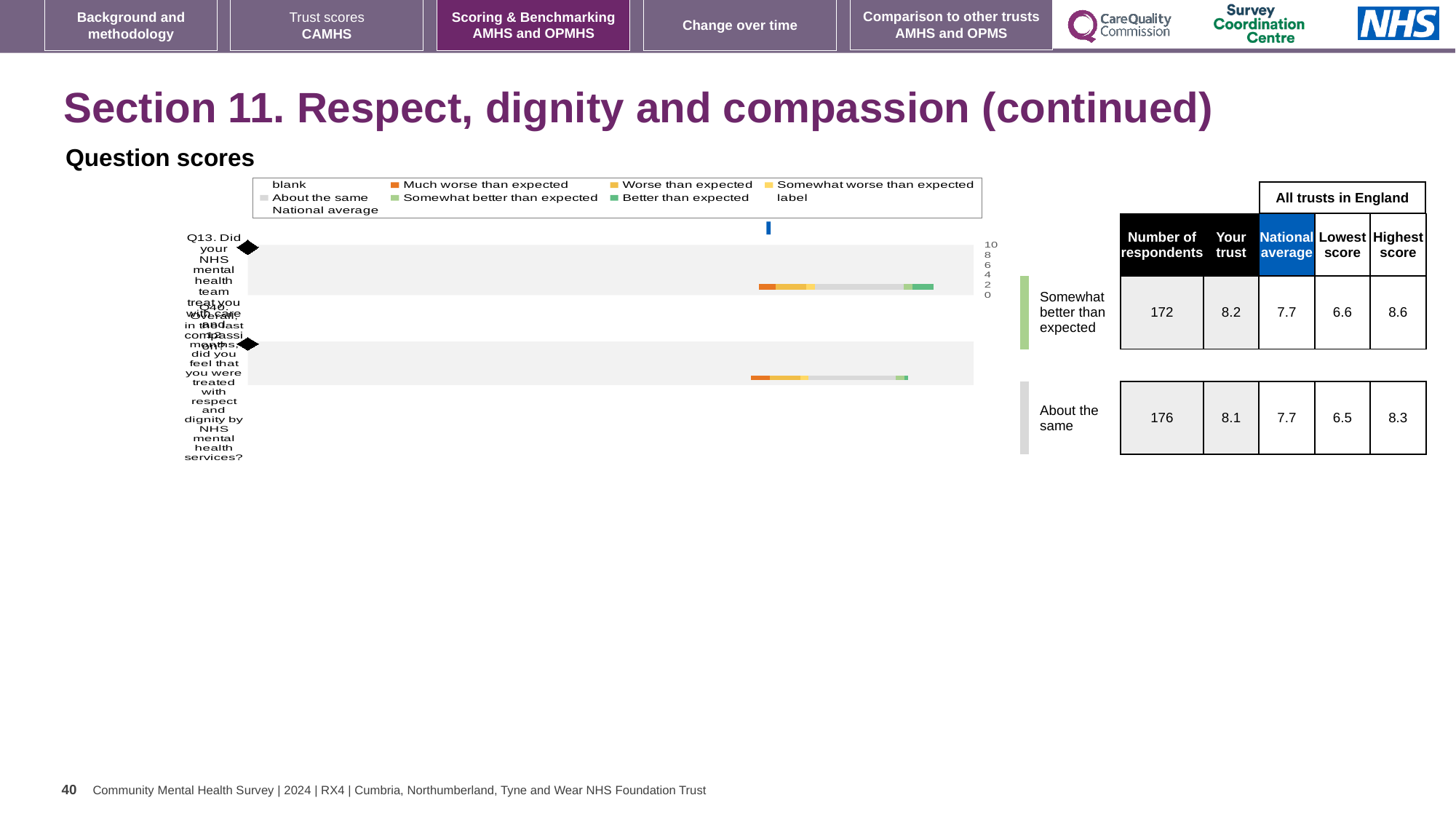
What kind of chart is shown under 'Question scores'? bar chart In the table beside the chart, what is the 'Lowest score' for the row labelled 'About the same'? 6.5 In the table beside the chart, what is the difference between the 'Highest score' and 'Lowest score' for the row labelled 'Somewhat better than expected'? 2.0 In the table beside the chart, what is the 'Highest score' for the row labelled 'Somewhat better than expected'? 8.6 In the table beside the chart, what is the 'Your trust' score for the row labelled 'About the same'? 8.1 In the table beside the chart, what is the 'Your trust' score for the row labelled 'Somewhat better than expected'? 8.2 What is the title shown above the chart? Question scores Which row in the table beside the chart has the higher 'Your trust' score, 'Somewhat better than expected' or 'About the same'? Somewhat better than expected In the table beside the chart, what is the 'National average' for the row labelled 'Somewhat better than expected'? 7.7 How many questions (categories) are plotted in the 'Question scores' chart? 2 In the table beside the chart, how many more respondents are listed for 'About the same' than for 'Somewhat better than expected'? 4 In the table beside the chart, how many respondents are listed for the row labelled 'About the same'? 176